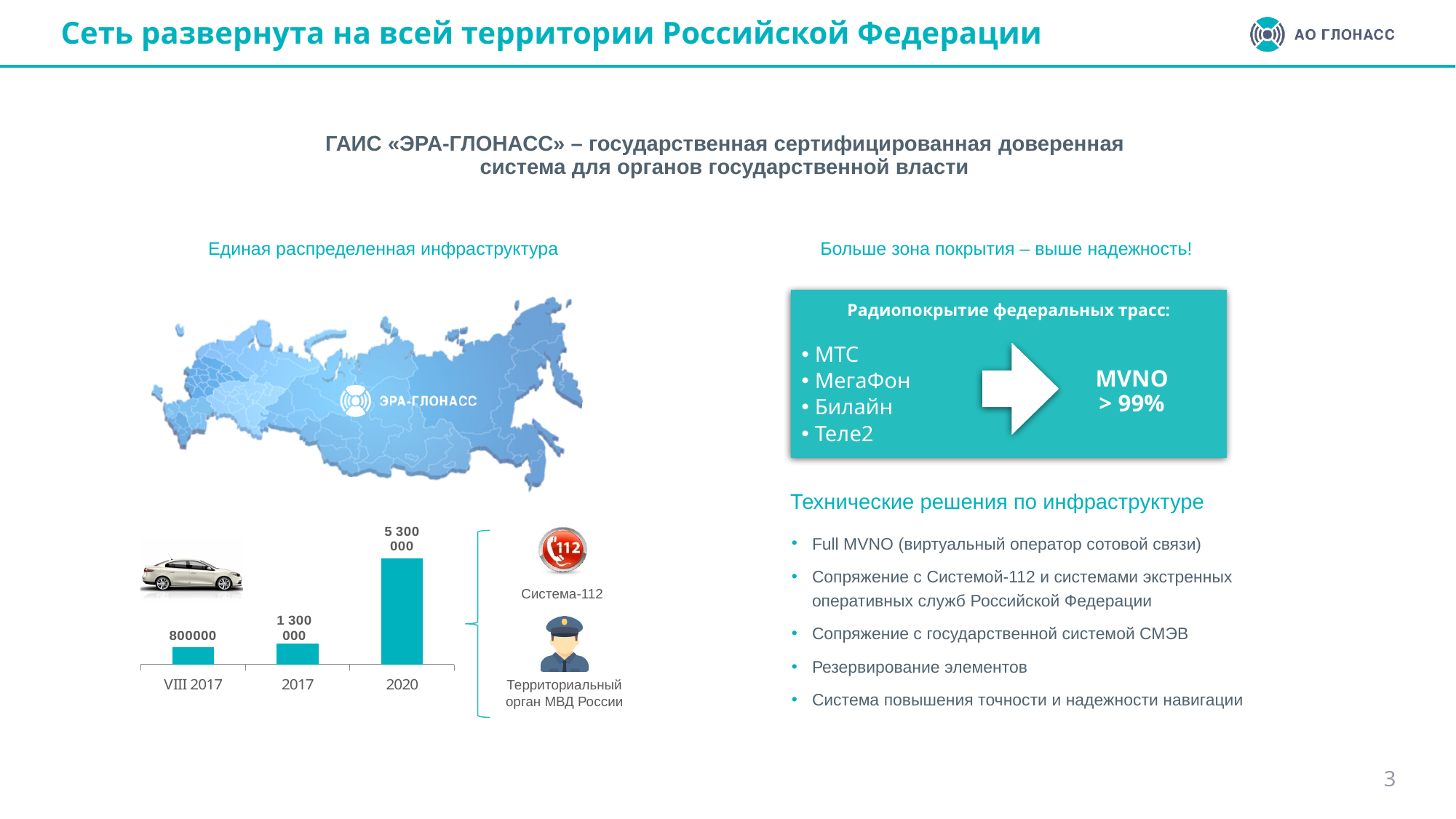
What is the value shown for 2017 in the bar chart? 1 300 000 What is the value shown for VIII 2017 in the bar chart? 800000 How many categories are shown in the bar chart? 3 What is the difference between the values for 2020 and 2017 in the bar chart? 4 000 000 Do the values in the bar chart rise or fall from VIII 2017 to 2020? rise What is the value shown for 2020 in the bar chart? 5 300 000 Which is larger in the bar chart: the value for 2017 or the value for VIII 2017? 2017 Which category has the highest value in the bar chart? 2020 What kind of chart is shown on the slide? bar chart What is the difference between the values for 2017 and VIII 2017 in the bar chart? 500 000 What colour are the bars in the bar chart? teal Which category has the lowest value in the bar chart? VIII 2017